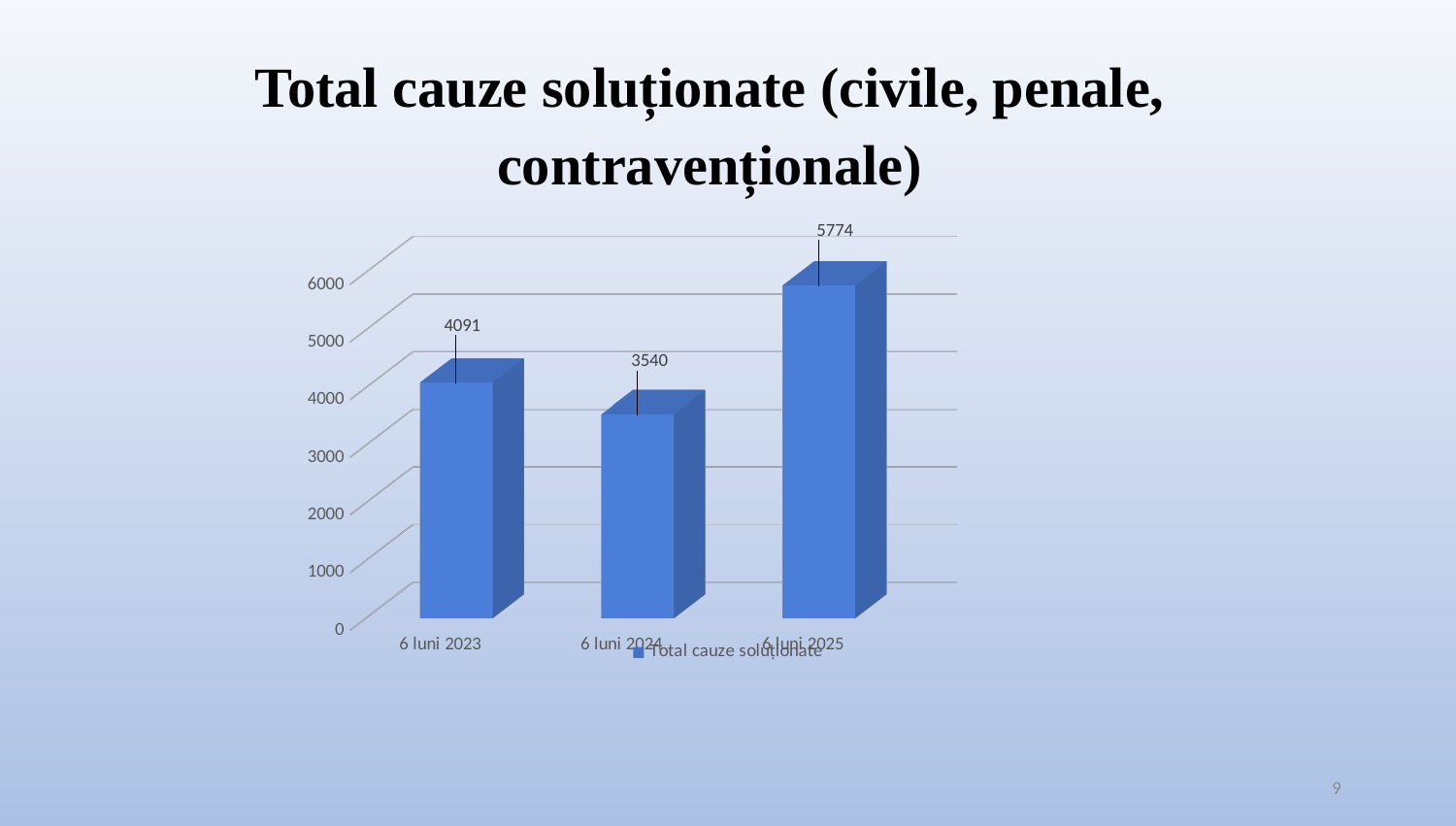
What is the difference between the values for 6 luni 2025 and 6 luni 2024? 2234 How many categories are shown on the x axis? 3 What is the value for 6 luni 2024? 3540 Which category has the lowest value? 6 luni 2024 Which category has the highest value? 6 luni 2025 What kind of chart is shown on the slide? bar chart What is the difference between the values for 6 luni 2023 and 6 luni 2024? 551 What is the title of the chart? Total cauze soluționate (civile, penale, contravenționale) What is the value for 6 luni 2023? 4091 Is the value for 6 luni 2025 greater or less than 5000? greater Which is larger, the value for 6 luni 2023 or the value for 6 luni 2024? 6 luni 2023 What is the value for 6 luni 2025? 5774